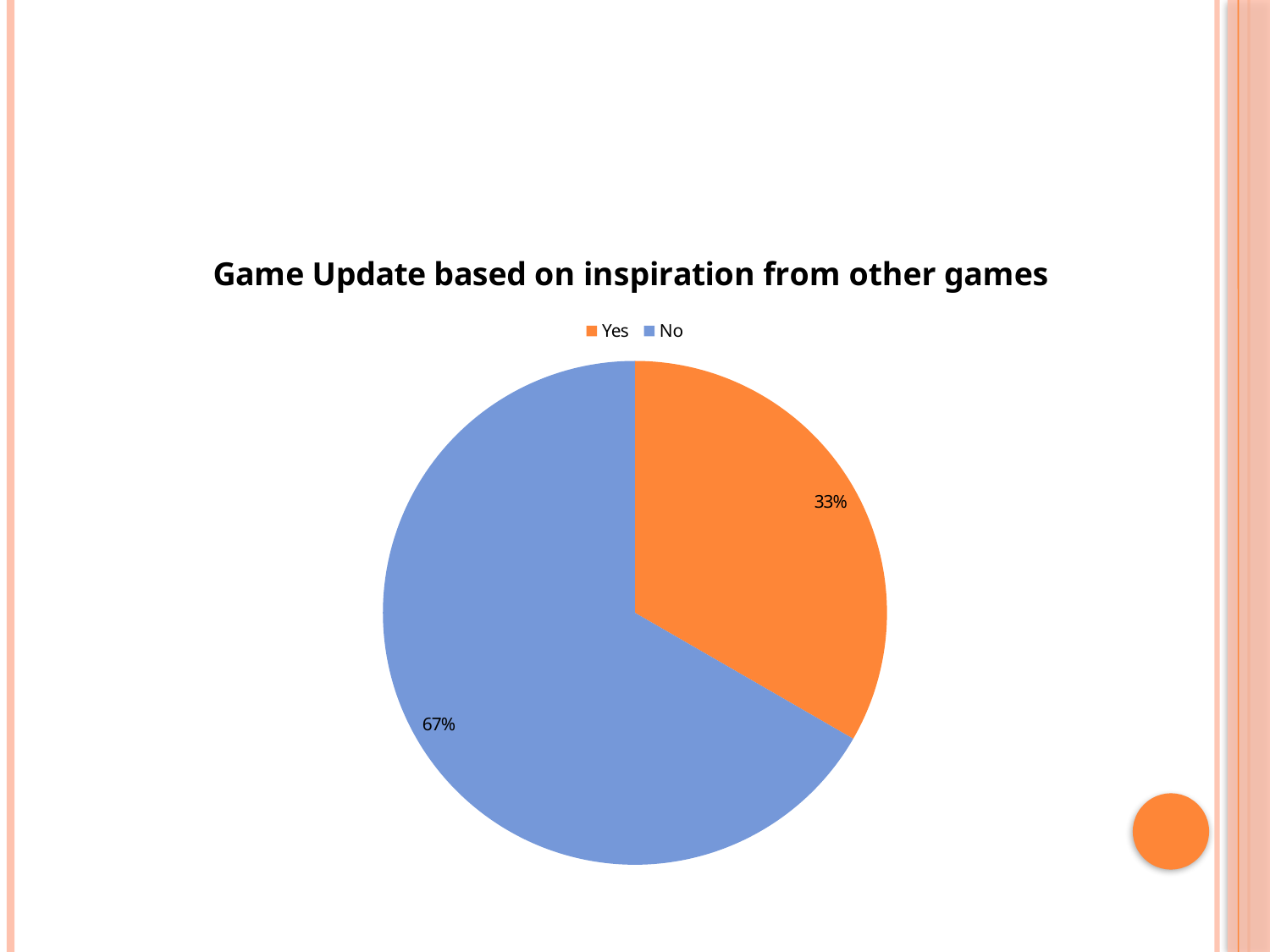
What is the title of the chart? Game Update based on inspiration from other games Which category has the largest slice of the pie? No What is the difference in percentage points between the No slice and the Yes slice? 34 How many slices does the pie chart have? 2 Which is larger, the Yes slice or the No slice? No What colour is the Yes slice? orange How many entries does the legend list? 2 What share of the pie does the Yes slice represent? 33% Which category has the smallest slice of the pie? Yes What share of the pie does the No slice represent? 67% What kind of chart is shown on the slide? pie chart